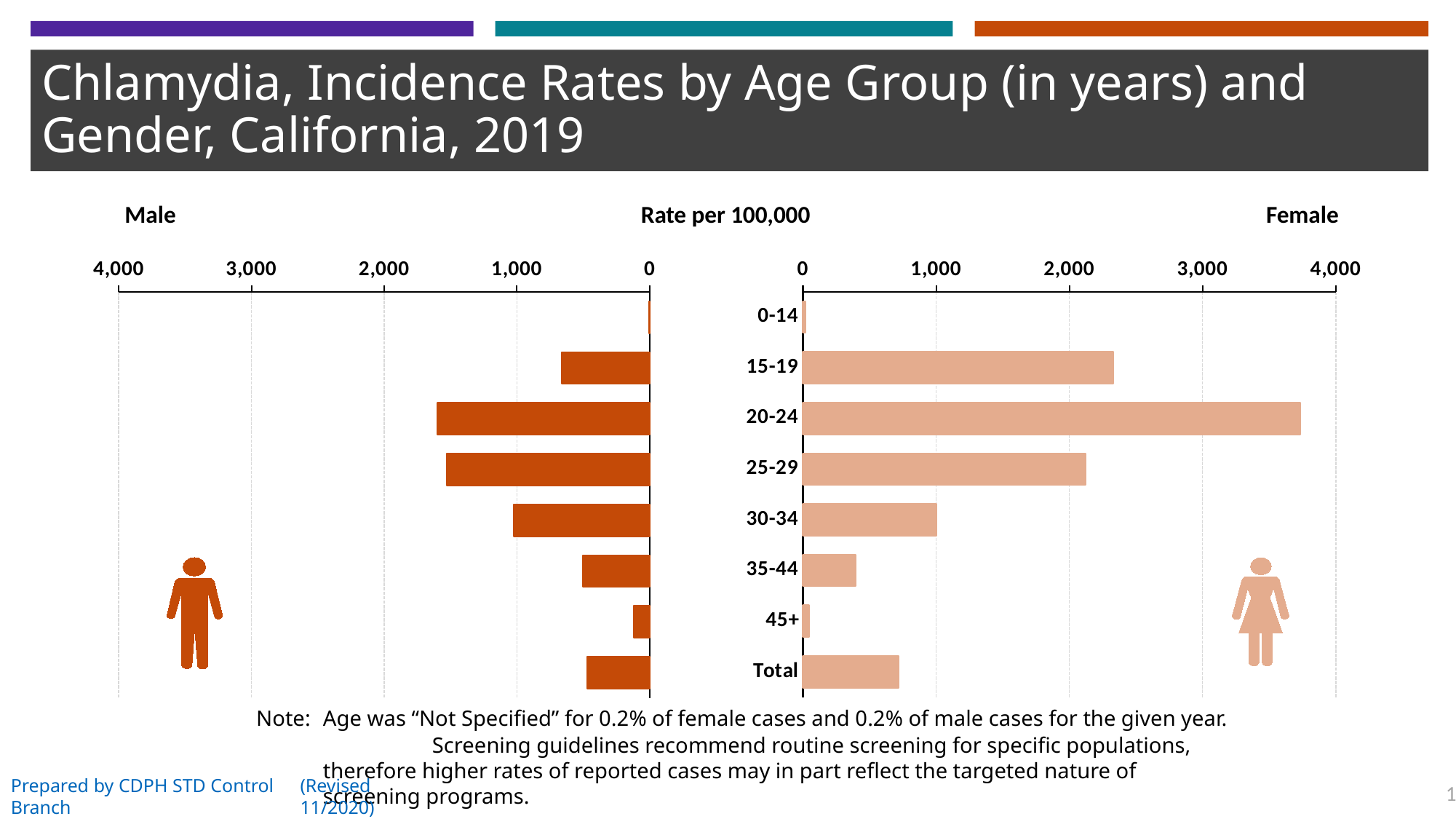
What kind of chart is shown on the slide? bar chart Is the male rate for 20-24 greater or less than 1,000? greater For the 20-24 age group, which gender has the higher rate? Female Which age group has the highest female rate? 20-24 Is the female Total rate greater or less than 1,000? less Which age group has the lowest male rate? 0-14 What unit is the rate measured in, according to the axis label? Rate per 100,000 How many gender groups are plotted on the chart? 2 How many categories (age groups plus Total) are listed on the chart? 8 Is the female rate for 15-19 greater or less than 2,000? greater